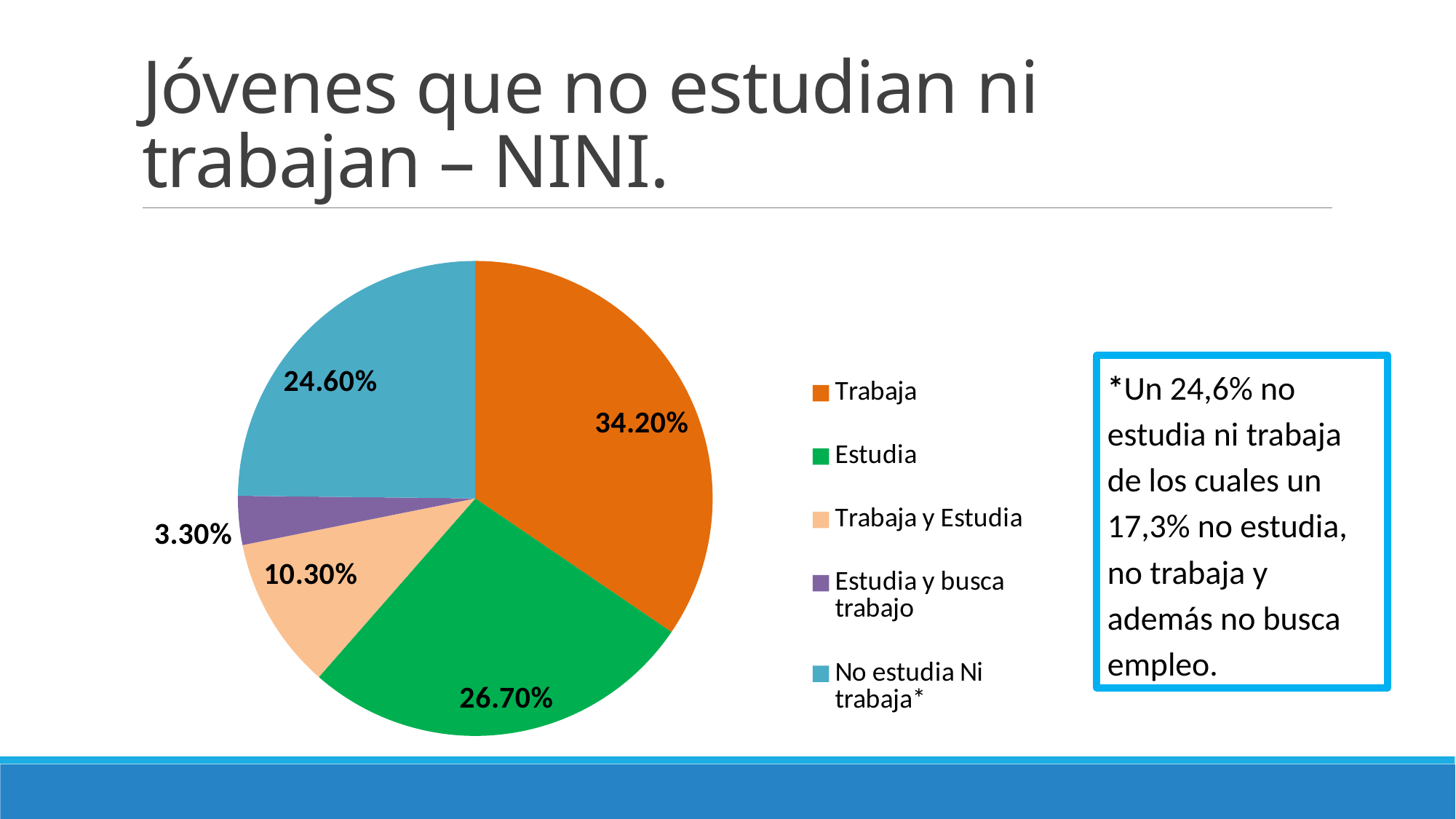
What is the value for No estudia Ni trabaja*? 24.60% Which category has the largest slice? Trabaja How many categories does the pie chart have? 5 Which category has the smallest slice? Estudia y busca trabajo Which is larger, the value for Estudia or the value for No estudia Ni trabaja*? Estudia What is the value for Trabaja? 34.20% What is the value for Estudia y busca trabajo? 3.30% What is the value for Trabaja y Estudia? 10.30% What is the difference between the values for Trabaja and Estudia? 7.50% What colour is the slice for No estudia Ni trabaja*? light blue What is the value for Estudia? 26.70% What kind of chart is shown on the slide? pie chart